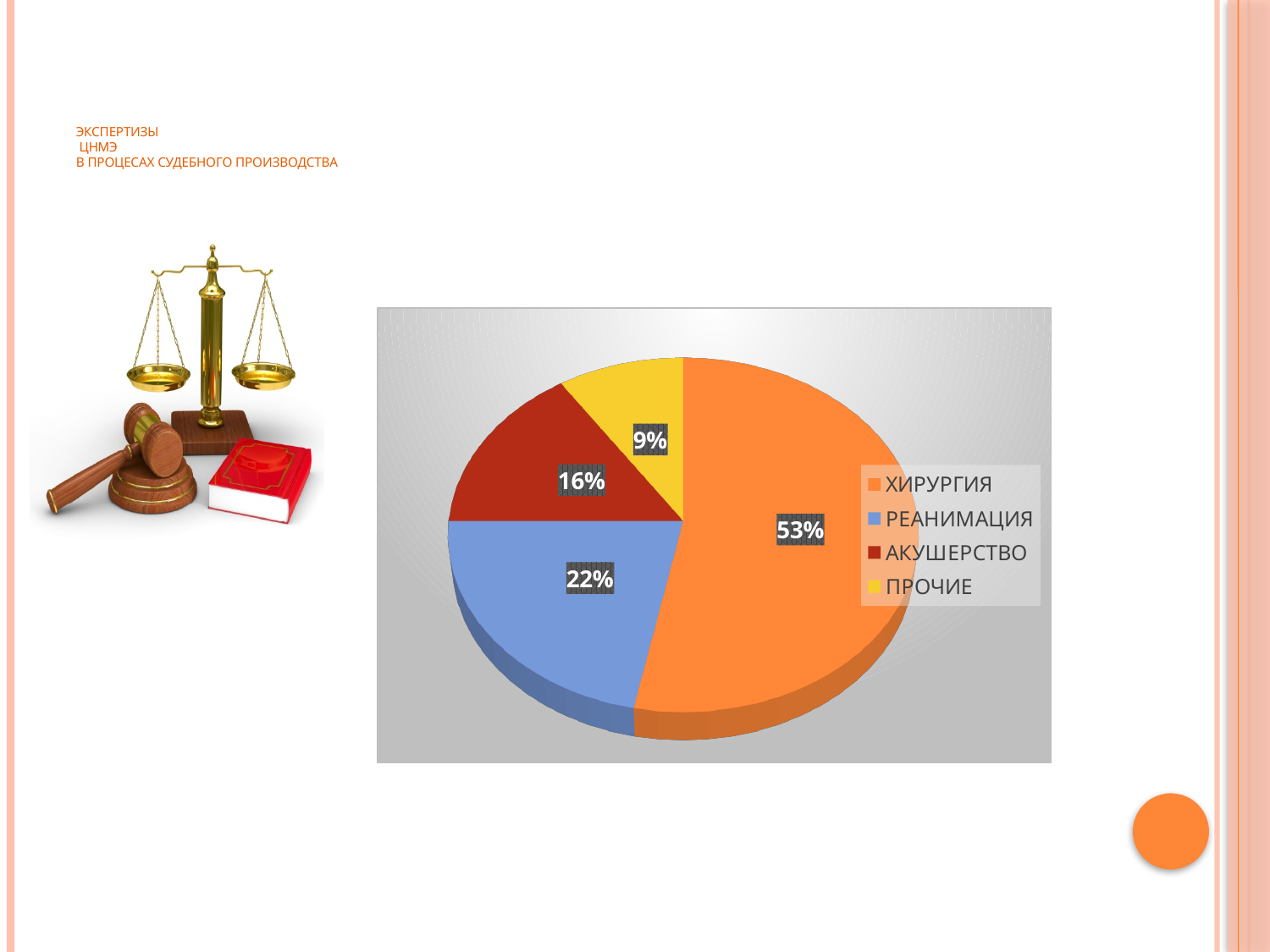
Which is larger, the share for РЕАНИМАЦИЯ or the share for АКУШЕРСТВО? РЕАНИМАЦИЯ What share of the pie does РЕАНИМАЦИЯ account for? 22% What is the difference in percentage points between ХИРУРГИЯ and РЕАНИМАЦИЯ? 31 What share of the pie does ПРОЧИЕ account for? 9% Which category has the smallest slice of the pie? ПРОЧИЕ What share of the pie does АКУШЕРСТВО account for? 16% What colour is the slice for РЕАНИМАЦИЯ? Blue What kind of chart is shown on the slide? Pie chart How many categories does the pie chart show? 4 Which category has the largest slice of the pie? ХИРУРГИЯ What is the difference in percentage points between АКУШЕРСТВО and ПРОЧИЕ? 7